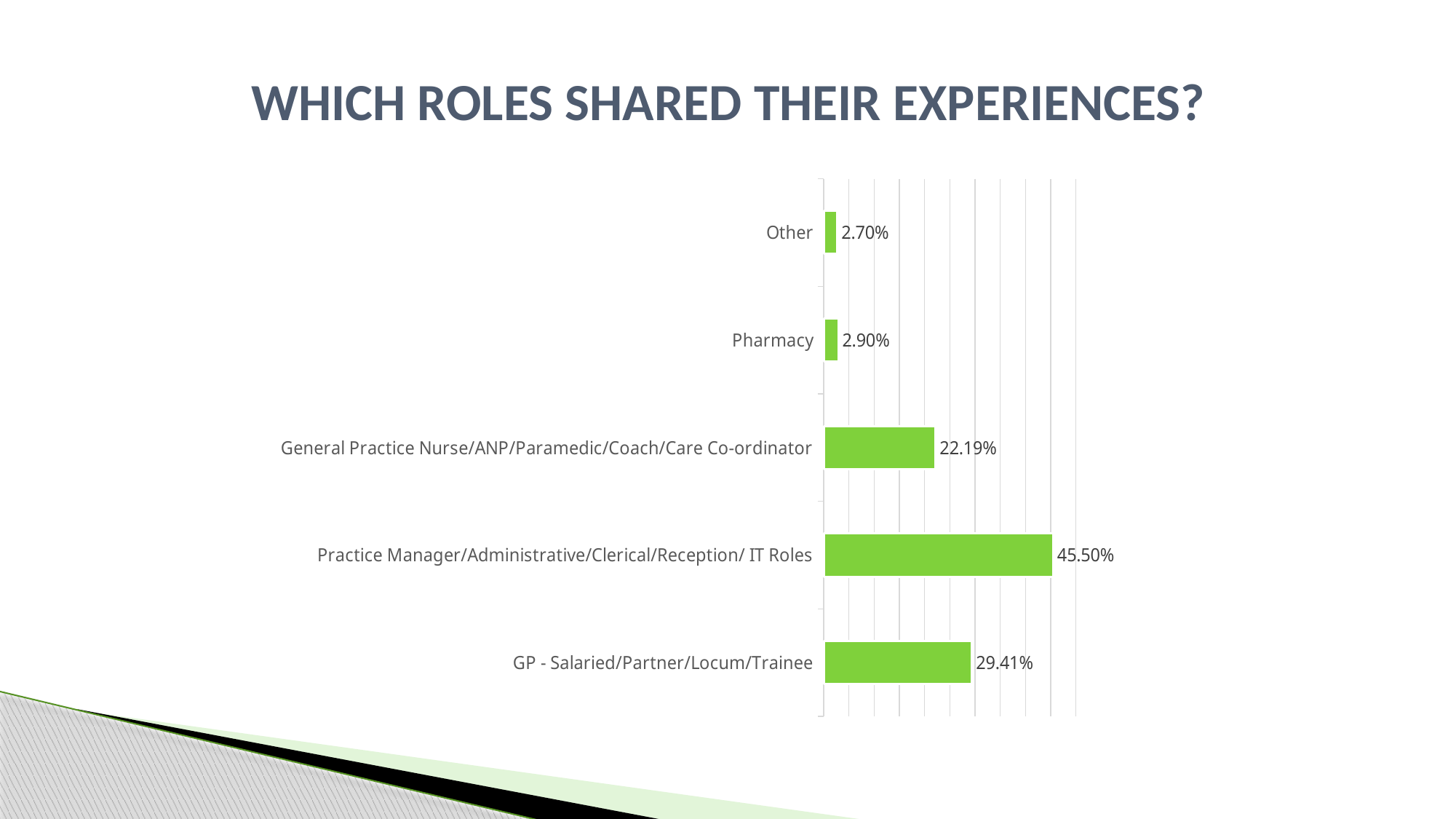
Which is larger, the value for GP - Salaried/Partner/Locum/Trainee or the value for General Practice Nurse/ANP/Paramedic/Coach/Care Co-ordinator? GP - Salaried/Partner/Locum/Trainee What percentage is shown for GP - Salaried/Partner/Locum/Trainee? 29.41% What is the difference in percentage points between Practice Manager/Administrative/Clerical/Reception/ IT Roles and GP - Salaried/Partner/Locum/Trainee? 16.09 What percentage is shown for Other? 2.70% What percentage is shown for Pharmacy? 2.90% What percentage is shown for Practice Manager/Administrative/Clerical/Reception/ IT Roles? 45.50% Which role category has the lowest percentage? Other What is the title of the slide? WHICH ROLES SHARED THEIR EXPERIENCES? What percentage is shown for General Practice Nurse/ANP/Paramedic/Coach/Care Co-ordinator? 22.19% Which role category has the highest percentage? Practice Manager/Administrative/Clerical/Reception/ IT Roles What kind of chart is shown on the slide? Bar chart How many role categories are shown in the chart? 5